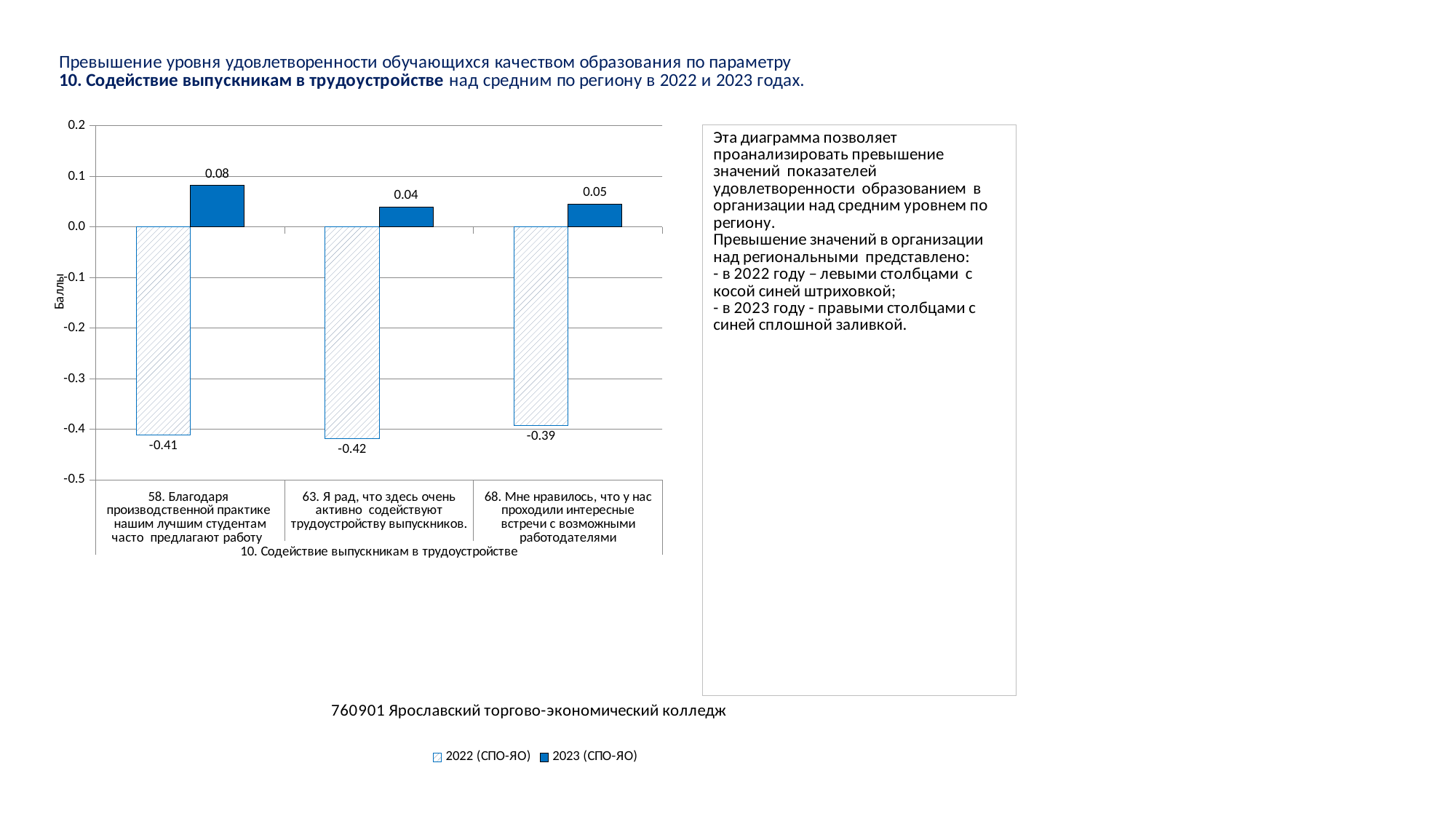
What is the value for 2023 (СПО-ЯО) for category "63. Я рад, что здесь очень активно содействуют трудоустройству выпускников."? 0.04 What is the value for 2022 (СПО-ЯО) for category "58. Благодаря производственной практике нашим лучшим студентам часто предлагают работу"? -0.41 What is the difference between the 2023 and 2022 values for category "58. Благодаря производственной практике нашим лучшим студентам часто предлагают работу"? 0.49 How many series does the legend list? 2 What is the label of the y axis of the chart? Баллы Which category has the lowest value for the 2022 (СПО-ЯО) series? 63. Я рад, что здесь очень активно содействуют трудоустройству выпускников. What kind of chart is shown on the slide? Bar chart What is the value for 2022 (СПО-ЯО) for category "68. Мне нравилось, что у нас проходили интересные встречи с возможными работодателями"? -0.39 How many categories are shown on the x axis of the chart? 3 Which category has the highest value for the 2023 (СПО-ЯО) series? 58. Благодаря производственной практике нашим лучшим студентам часто предлагают работу Which is larger: the 2023 value for category 63 or the 2023 value for category 68? The 2023 value for category 68 (0.05) What is the value for 2023 (СПО-ЯО) for category "58. Благодаря производственной практике нашим лучшим студентам часто предлагают работу"? 0.08